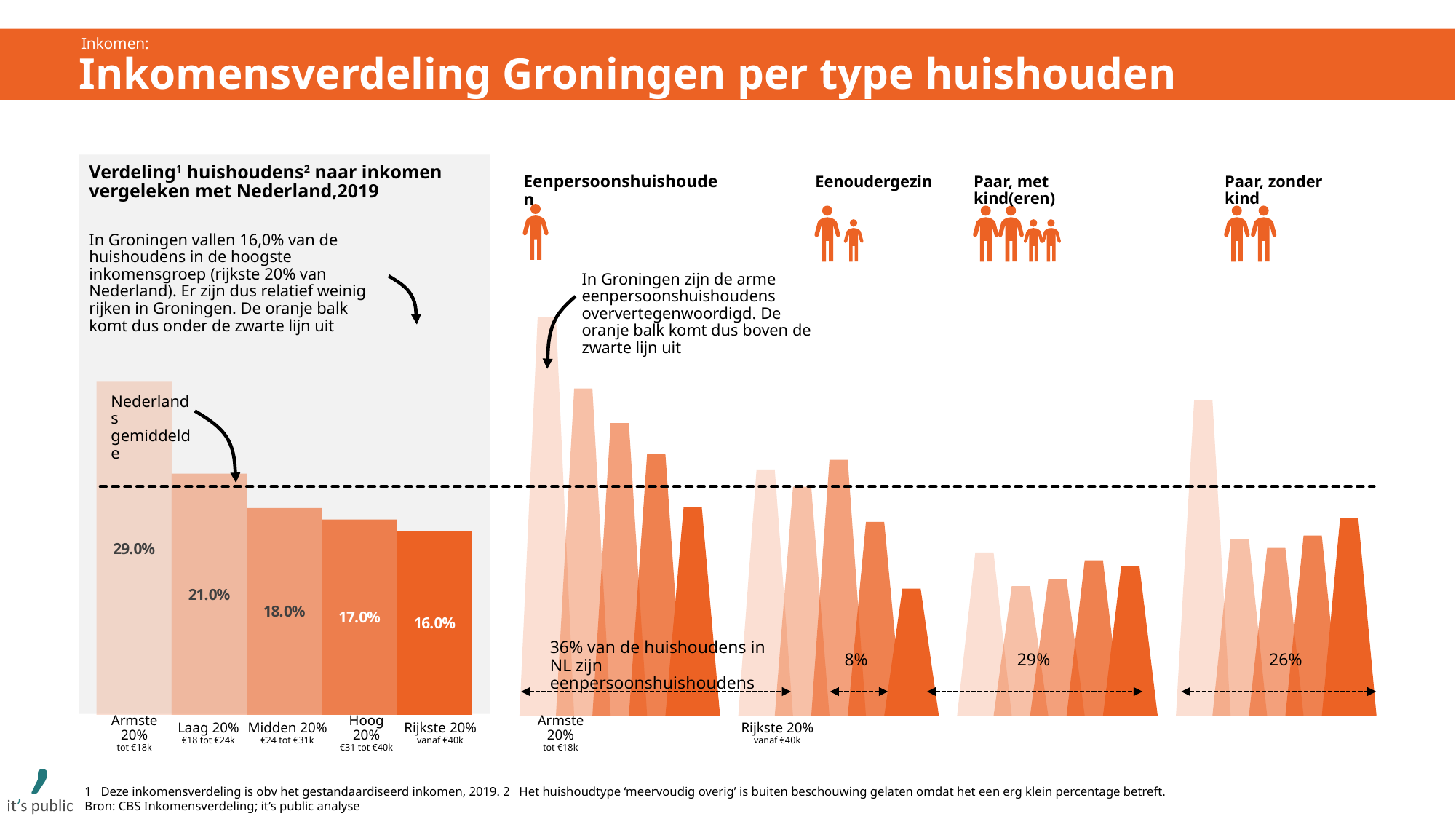
In the left chart, which is larger: the value for Laag 20% or the value for Hoog 20%? Laag 20% In the left chart, what is the value for Midden 20%? 18.0% In the left chart, do the values rise or fall from Armste 20% to Rijkste 20%? fall In the left chart, which income group has the lowest value? Rijkste 20% In the left chart, what is the value for Rijkste 20%? 16.0% In the right chart, what percentage of households in NL are eenpersoonshuishoudens? 36% What kind of chart is the left chart? bar chart In the left chart (Verdeling huishoudens naar inkomen), what is the value for Armste 20%? 29.0% In the left chart, which income group has the highest value? Armste 20% In the left chart, what is the difference between the values for Armste 20% and Rijkste 20%? 13.0% How many household types are shown in the right chart? 4 How many income groups are shown in the left chart? 5